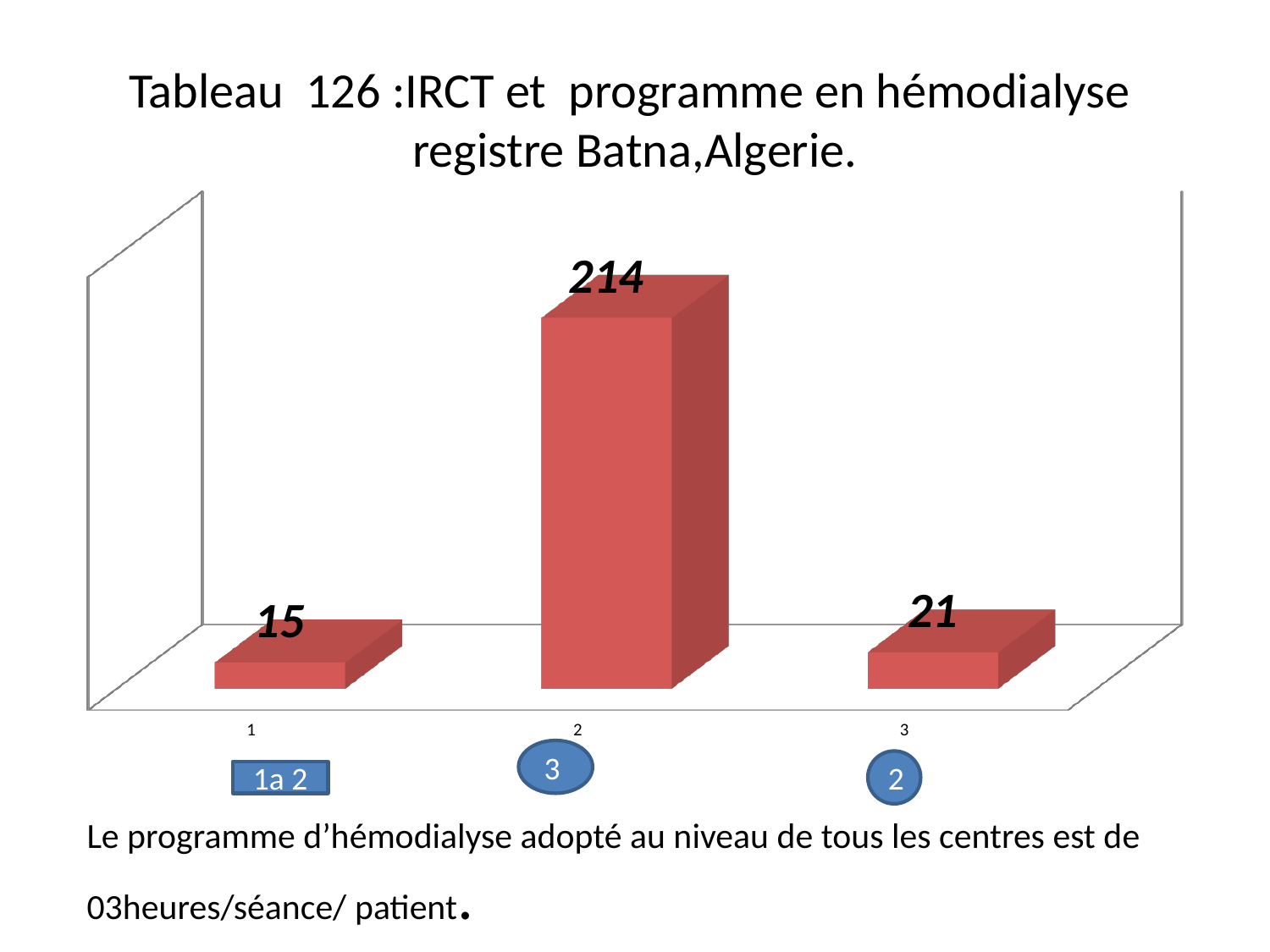
What is the value of the bar for category 3? 21 What is the value of the bar for category 1? 15 What is the sum of the three values shown in the chart? 250 What kind of chart is shown on the slide? bar chart What is the title of the chart on the slide? Tableau 126 :IRCT et programme en hémodialyse registre Batna,Algerie. Which category has the highest bar? 2 How many bars are plotted in the chart? 3 Which is larger, the value for category 1 or the value for category 3? category 3 What is the difference between the values for category 3 and category 1? 6 What is the difference between the values for category 2 and category 3? 193 What is the value of the bar for category 2? 214 Which category has the lowest bar? 1